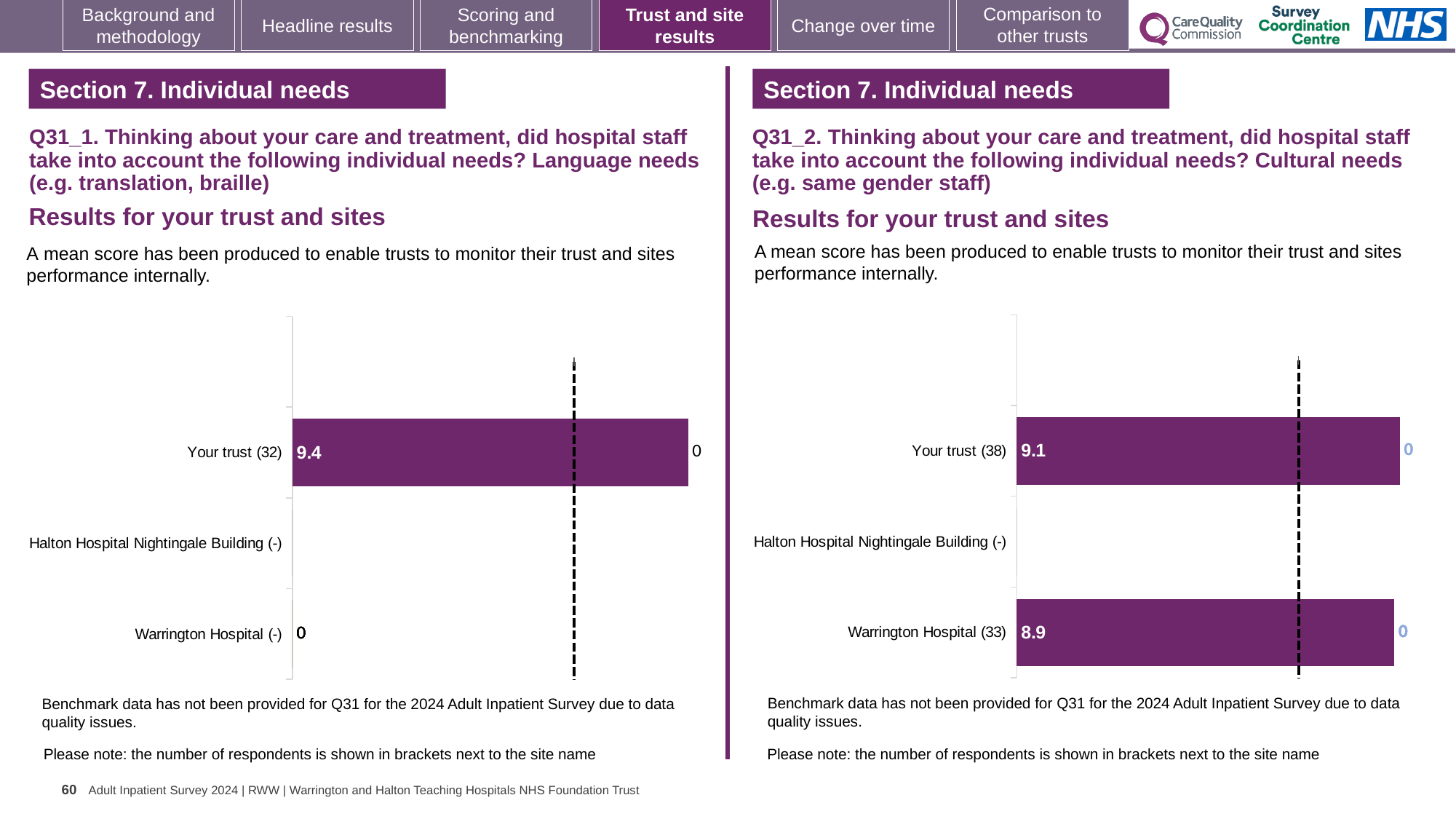
On the left chart (Q31_1, Language needs), what is the mean score for Your trust? 9.4 How many categories are listed on the left chart (Q31_1, Language needs)? 3 On the right chart (Q31_2, Cultural needs), which has the higher score: Your trust or Warrington Hospital? Your trust On the right chart (Q31_2, Cultural needs), what is the mean score for Warrington Hospital? 8.9 On the right chart (Q31_2, Cultural needs), which category has the highest score? Your trust What type of chart is used on the left (Q31_1, Language needs)? Bar chart On the right chart (Q31_2, Cultural needs), what is the mean score for Your trust? 9.1 On the left chart (Q31_1, Language needs), how many respondents are shown in brackets for Your trust? 32 On the right chart (Q31_2, Cultural needs), which category has no bar plotted? Halton Hospital Nightingale Building How many categories are listed on the right chart (Q31_2, Cultural needs)? 3 On the right chart (Q31_2, Cultural needs), what is the difference between the scores for Your trust and Warrington Hospital? 0.2 On the right chart (Q31_2, Cultural needs), how many respondents are shown in brackets for Warrington Hospital? 33